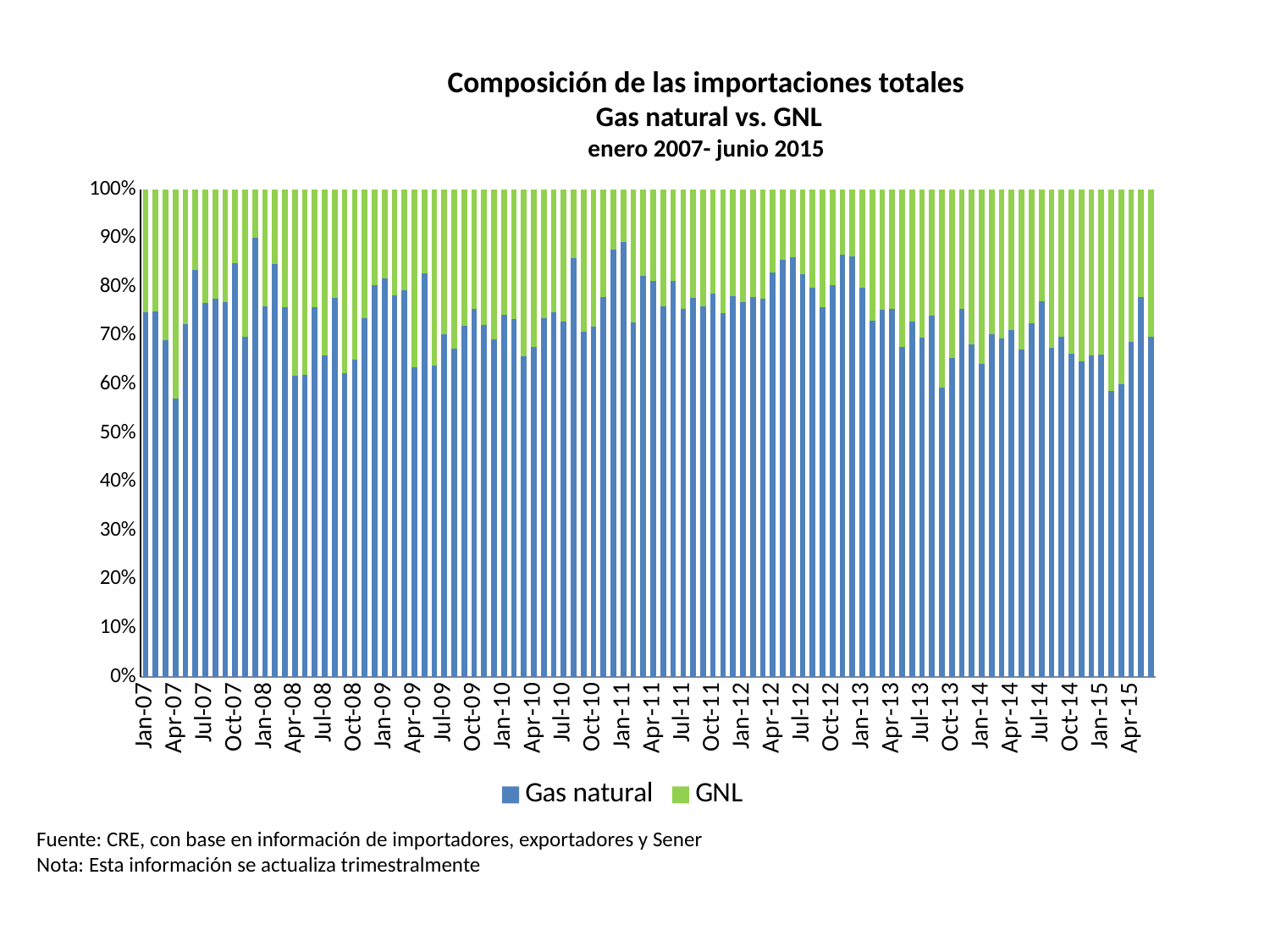
Is the Gas natural share for Jan-11 greater or less than 80%? greater Which colour represents GNL in the chart? Green How many series does the legend list? 2 Is the GNL share for Apr-07 greater or less than 30%? greater Is the Gas natural share for Jan-08 greater or less than 80%? less What is the maximum value shown on the vertical axis? 100% What kind of chart is shown on the slide? Stacked bar chart What are the two series named in the legend? Gas natural and GNL Which has the larger Gas natural share, Jan-08 or Apr-07? Jan-08